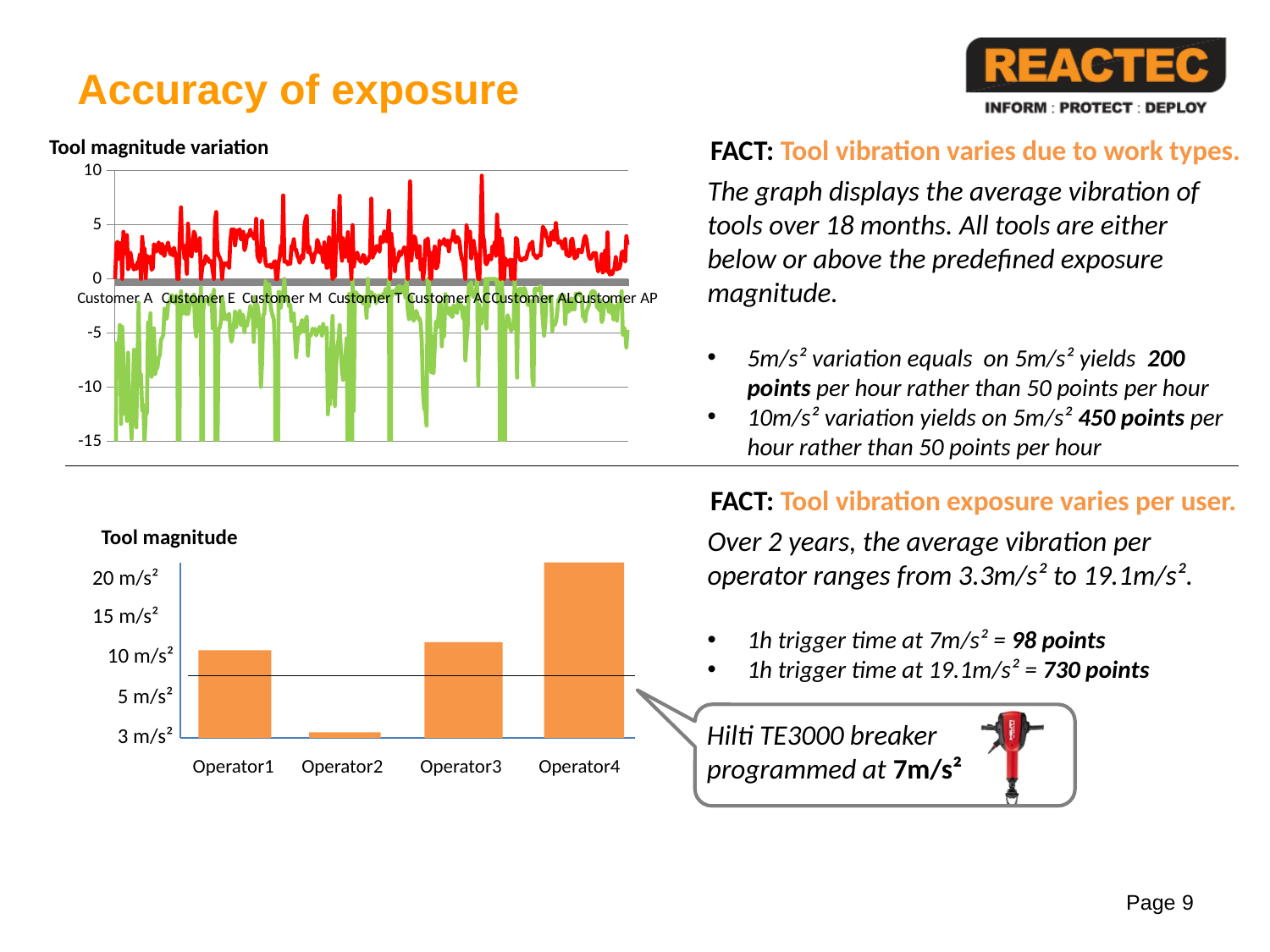
In the 'Tool magnitude variation' chart, which line stays above 0, the red line or the green line? the red line In the 'Tool magnitude' chart, is the value for Operator2 greater or less than 5 m/s²? less How many customer labels are shown on the x axis of the 'Tool magnitude variation' chart? 7 In the 'Tool magnitude' chart, which operator has the lowest value? Operator2 What is the lowest value shown on the y axis of the 'Tool magnitude variation' chart? -15 What kind of chart is the 'Tool magnitude variation' chart at the top left of the slide? line chart In the 'Tool magnitude' chart, which is larger, the value for Operator4 or the value for Operator1? Operator4 How many operators are shown on the x axis of the 'Tool magnitude' chart? 4 In the 'Tool magnitude' chart, is the value for Operator3 greater or less than 10 m/s²? greater In the 'Tool magnitude' chart, is the value for Operator1 greater or less than 15 m/s²? less What kind of chart is the 'Tool magnitude' chart at the bottom left of the slide? bar chart In the 'Tool magnitude' chart, which operator has the highest value? Operator4